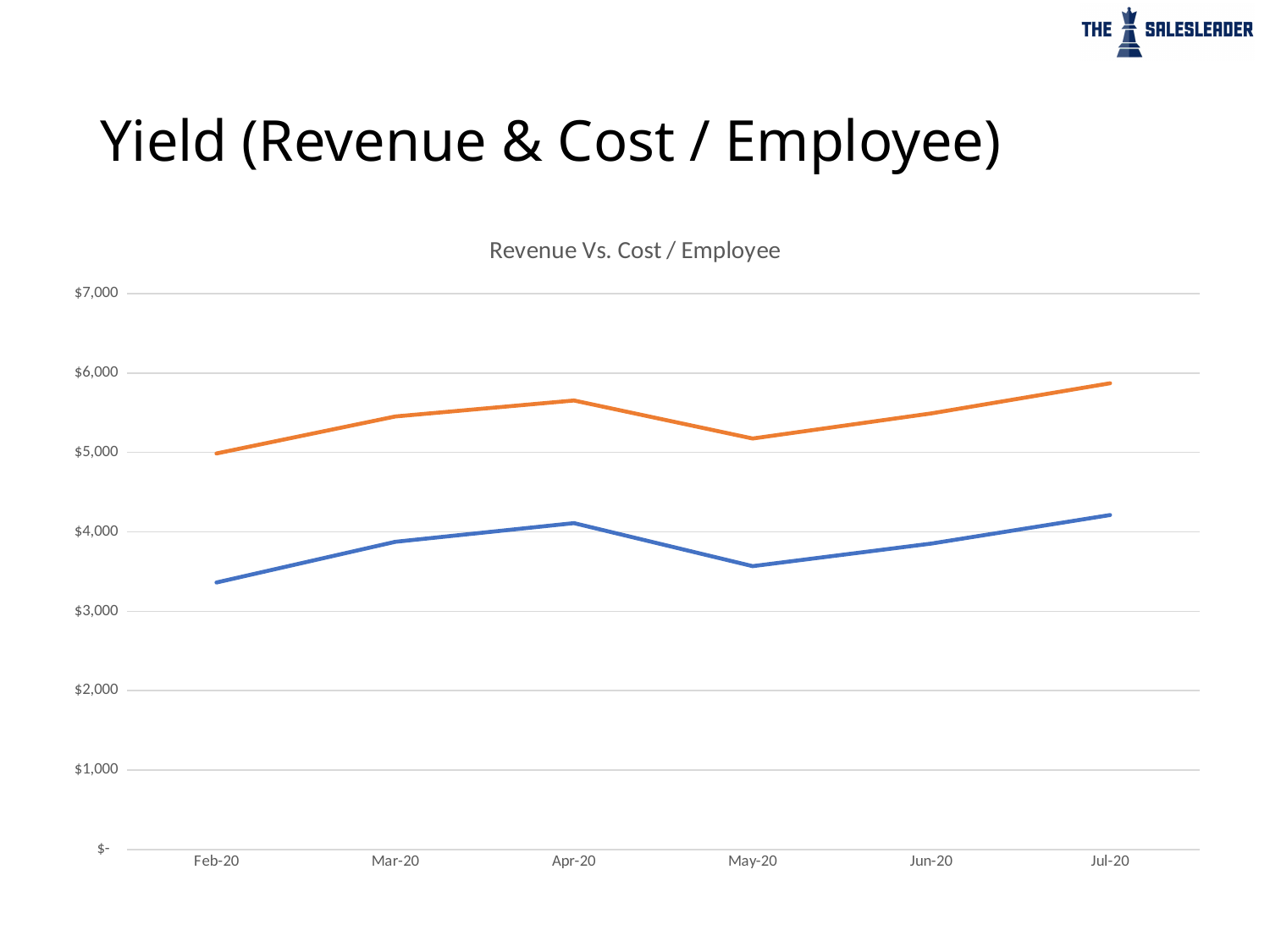
In which month does the orange line reach its highest value? Jul-20 How many months are shown on the x axis of the chart? 6 Is the value of the blue line for May-20 greater or less than $4,000? less How many lines are plotted on the chart? 2 Do both lines rise or fall from Apr-20 to May-20? fall Is the value of the blue line for Feb-20 greater or less than $3,000? greater What kind of chart is shown on the slide? line chart What is the title of the chart? Revenue Vs. Cost / Employee In which month is the blue line at its lowest value? Feb-20 Which line has the higher value in Jun-20, the orange line or the blue line? the orange line Is the value of the orange line for Jul-20 greater or less than $6,000? less